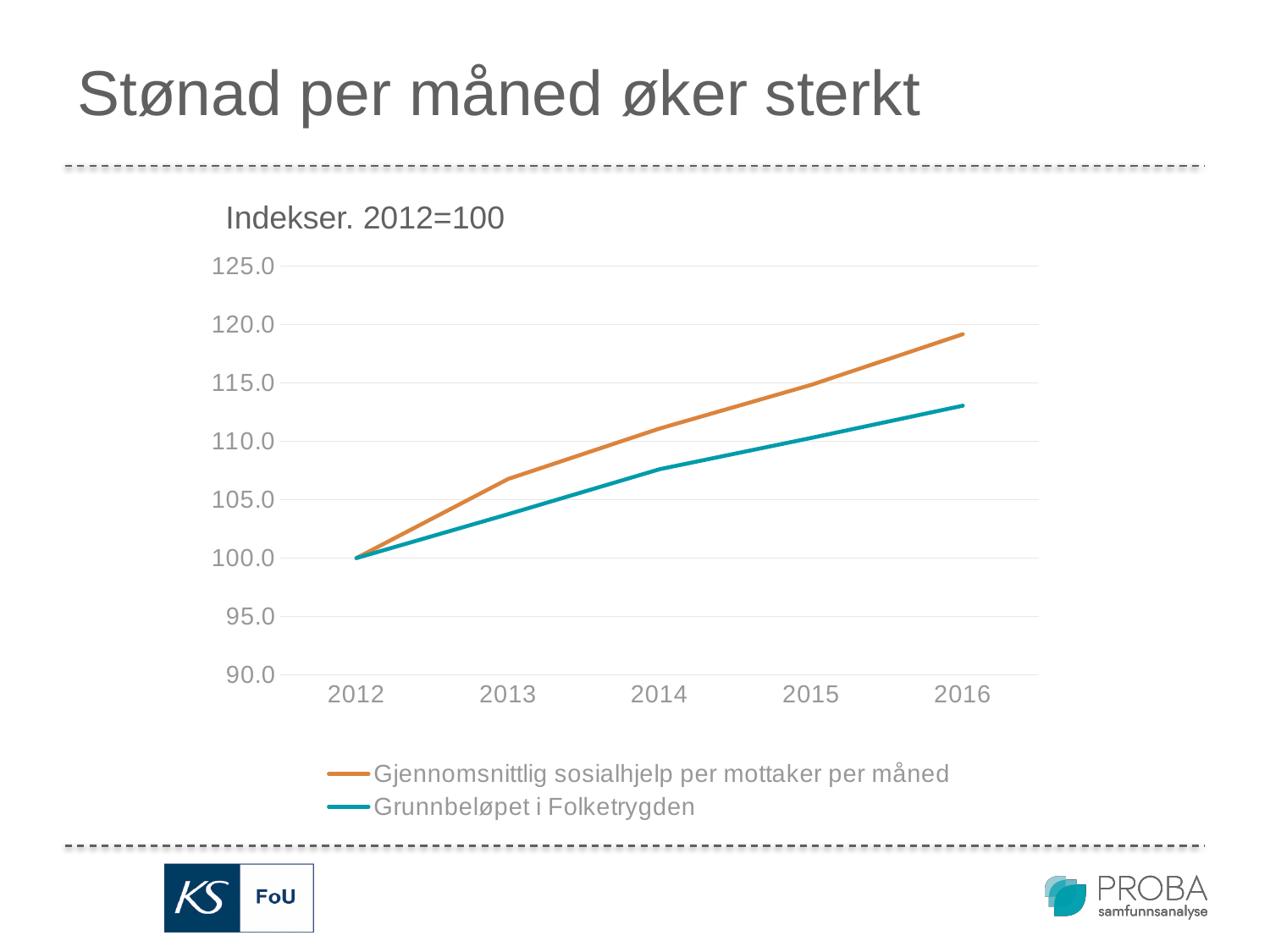
What is the value of Grunnbeløpet i Folketrygden in 2012? 100.0 What is the value of Gjennomsnittlig sosialhjelp per mottaker per måned in 2012? 100.0 Is the value for Grunnbeløpet i Folketrygden in 2013 greater or less than 105.0? less In which year is Grunnbeløpet i Folketrygden lowest? 2012 In which year is Gjennomsnittlig sosialhjelp per mottaker per måned highest? 2016 Which series has the higher value in 2016, Gjennomsnittlig sosialhjelp per mottaker per måned or Grunnbeløpet i Folketrygden? Gjennomsnittlig sosialhjelp per mottaker per måned Do the values for Grunnbeløpet i Folketrygden rise or fall from 2012 to 2016? Rise Is the value for Gjennomsnittlig sosialhjelp per mottaker per måned in 2016 greater or less than 115.0? greater How many years are shown on the x axis? 5 What is the title shown above the chart? Indekser. 2012=100 How many series does the legend list? 2 What kind of chart is shown on the slide? Line chart